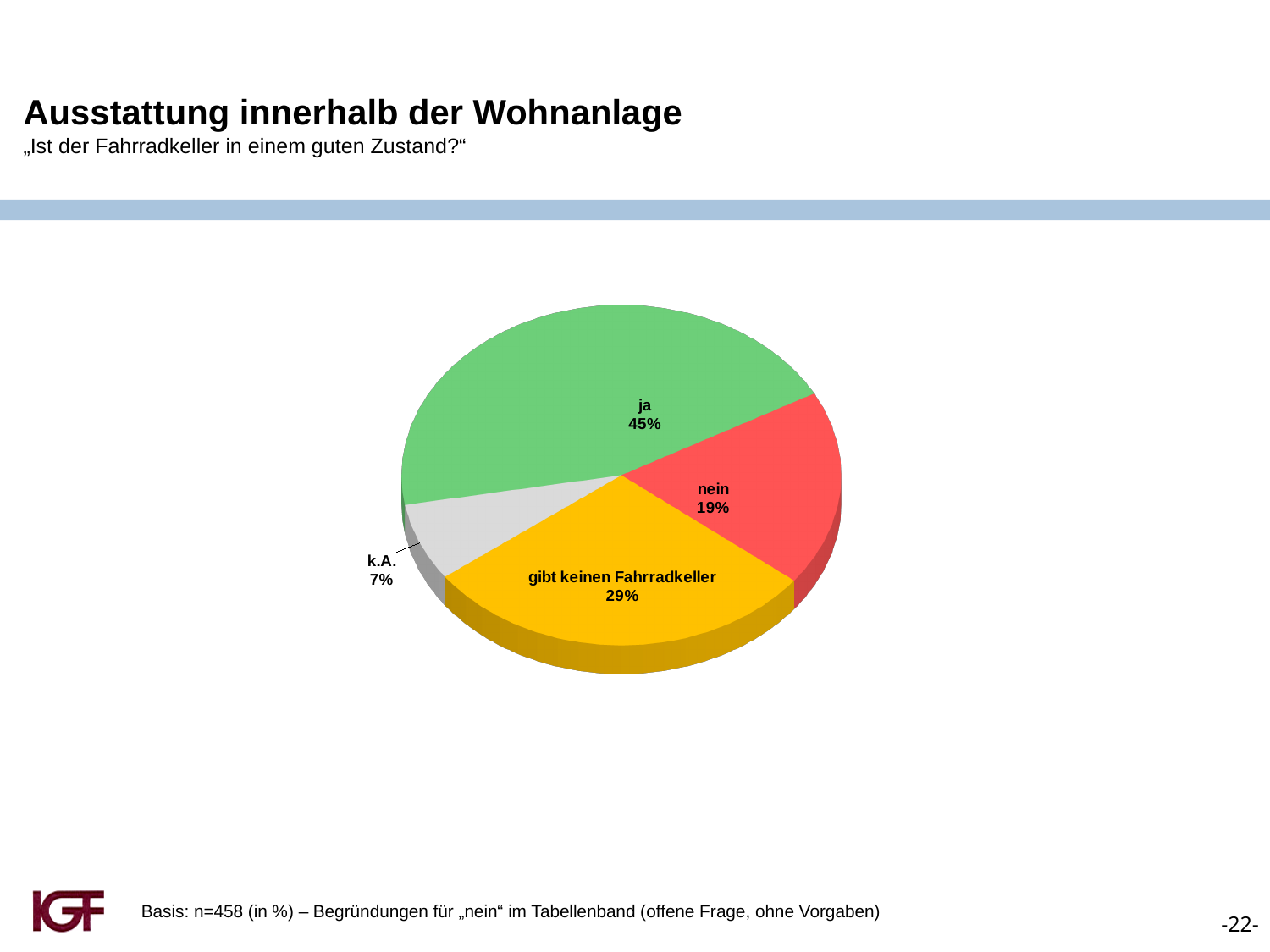
What is the difference in percentage points between "ja" and "nein"? 26 What percentage of respondents answered "ja"? 45% What type of chart is shown on the slide? pie chart Which category has the smallest share of the pie? k.A. Which is larger, the share for "nein" or the share for "gibt keinen Fahrradkeller"? gibt keinen Fahrradkeller What is the combined share of "ja" and "nein"? 64% What percentage is shown for "k.A."? 7% How many slices does the pie chart have? 4 Which category has the largest share of the pie? ja What colour is the slice for "nein"? red What percentage of respondents answered "nein"? 19% What share of the pie is labelled "gibt keinen Fahrradkeller"? 29%